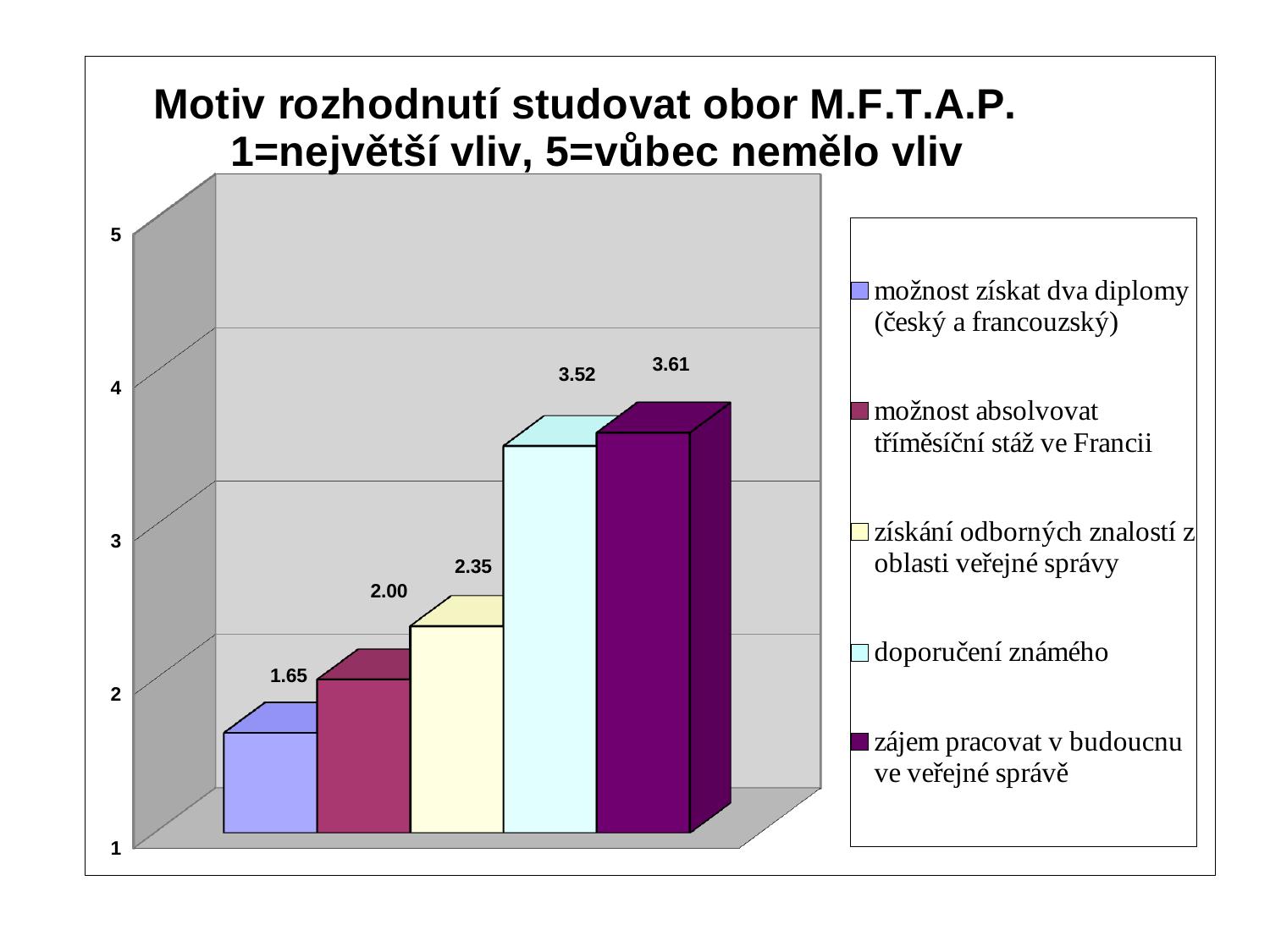
What kind of chart is shown on the slide? bar chart What is the difference between the values for "doporučení známého" and "možnost získat dva diplomy (český a francouzský)"? 1.87 What is the value for "doporučení známého"? 3.52 How many bars are plotted in the chart? 5 What is the value for "možnost získat dva diplomy (český a francouzský)"? 1.65 Which is larger: the value for "získání odborných znalostí z oblasti veřejné správy" or the value for "možnost absolvovat tříměsíční stáž ve Francii"? získání odborných znalostí z oblasti veřejné správy What is the title of the chart? Motiv rozhodnutí studovat obor M.F.T.A.P. 1=největší vliv, 5=vůbec nemělo vliv Which category has the lowest value? možnost získat dva diplomy (český a francouzský) What is the value for "získání odborných znalostí z oblasti veřejné správy"? 2.35 What is the value for "možnost absolvovat tříměsíční stáž ve Francii"? 2.00 What is the value for "zájem pracovat v budoucnu ve veřejné správě"? 3.61 Which category has the highest value? zájem pracovat v budoucnu ve veřejné správě